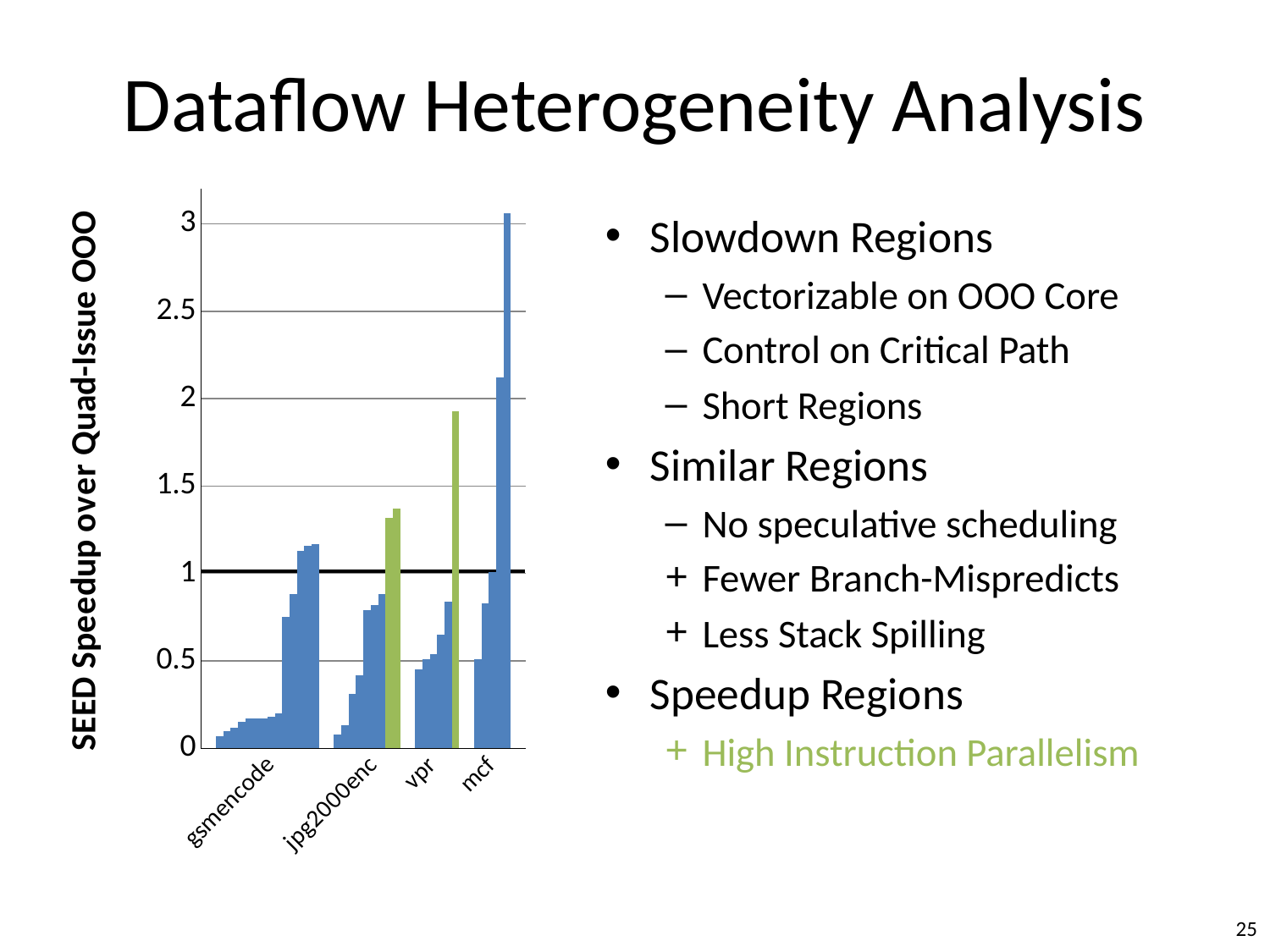
Is the green bar in the vpr group greater or less than 1.5? greater Within each benchmark group, do the bars rise or fall from left to right? rise Are the green bars in the jpg2000enc group greater or less than 1.5? less Which benchmark group contains the tallest bar in the chart? mcf Is the tallest bar in the mcf group greater or less than 2.5? greater Which group has a taller tallest bar, gsmencode or vpr? vpr How many benchmark names are labelled along the x axis of the chart? 4 What is the label of the y axis of the chart? SEED Speedup over Quad-Issue OOO At what y-axis value is the thick horizontal black line drawn across the chart? 1 What kind of chart is shown on the slide? bar chart